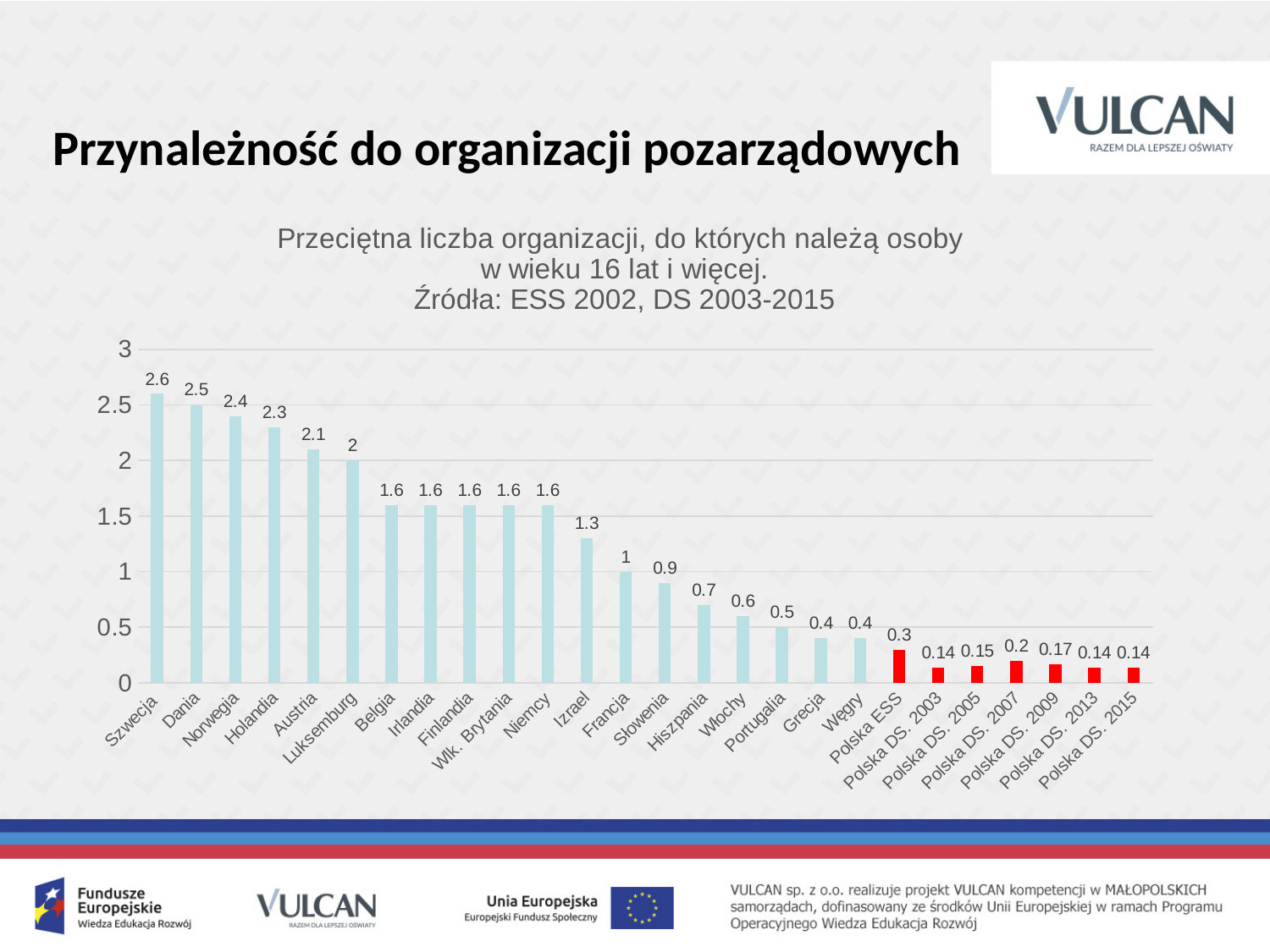
What is the difference between the values for Szwecja and Dania? 0.1 What is the value for Polska ESS? 0.3 Which category has the highest value? Szwecja Do the values generally rise or fall from Szwecja to Węgry along the x axis? fall What kind of chart is shown on the slide? bar chart What is the value for Szwecja? 2.6 Which is larger, the value for Francja or the value for Słowenia? Francja What is the value for Polska DS. 2007? 0.2 What is the value for Izrael? 1.3 What is the difference between the values for Polska ESS and Polska DS. 2003? 0.16 How many categories are shown on the x axis? 26 Is the value for Austria greater or less than 2? greater